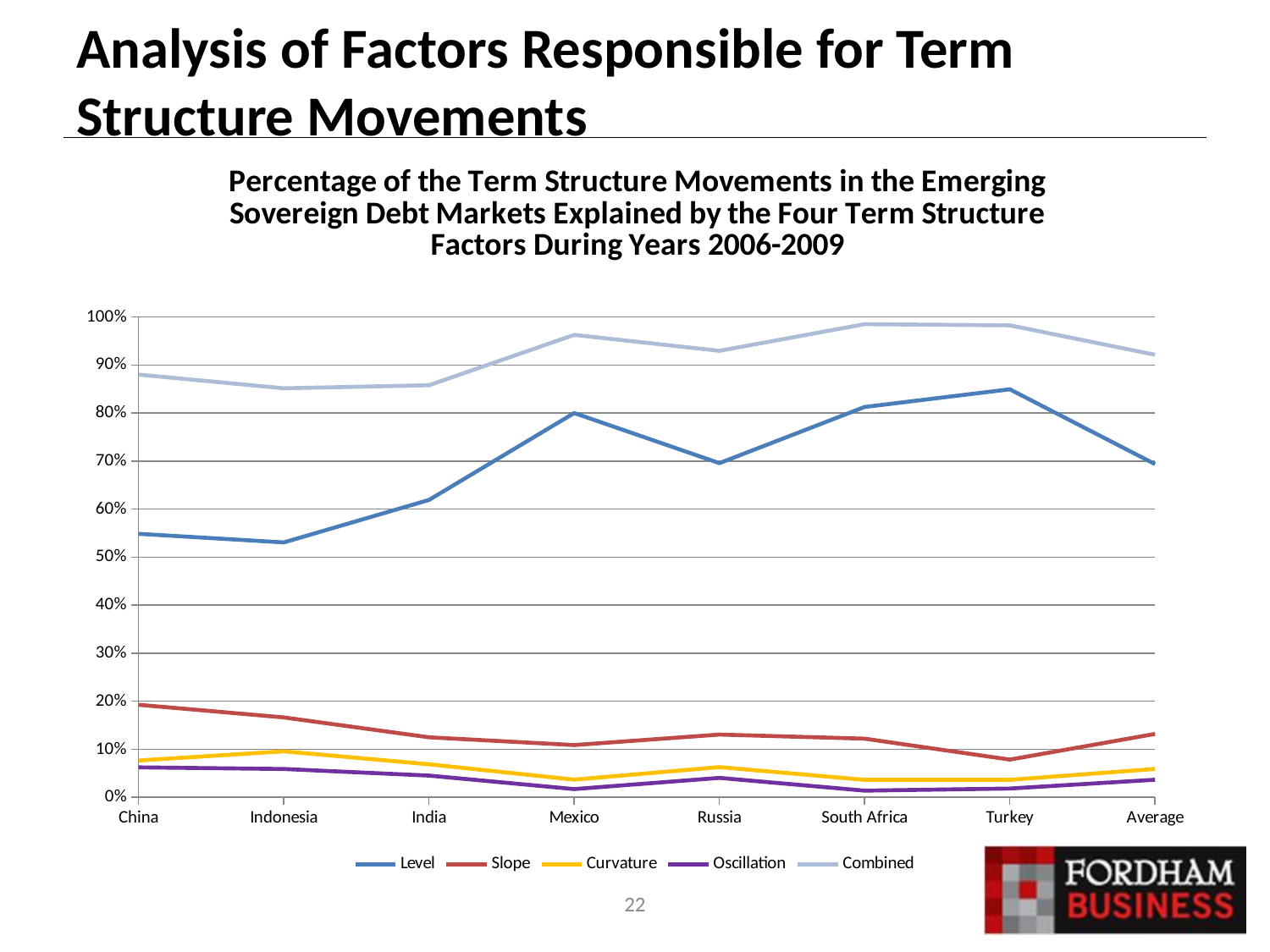
Is the Level value for China greater or less than 60%? less How many categories are shown along the x axis? 8 Which is larger, the Level value for Mexico or the Level value for Russia? Mexico Which series is plotted as the topmost line across all categories? Combined Is the Level value for Mexico greater or less than 70%? greater Is the Combined value for Indonesia greater or less than 90%? less Does the Slope series rise or fall from China to India? Fall How many series does the legend list? 5 Which category has the lowest value for the Slope series? Turkey What kind of chart is shown on the slide? Line chart Which category has the highest value for the Level series? Turkey Which category has the highest value for the Slope series? China